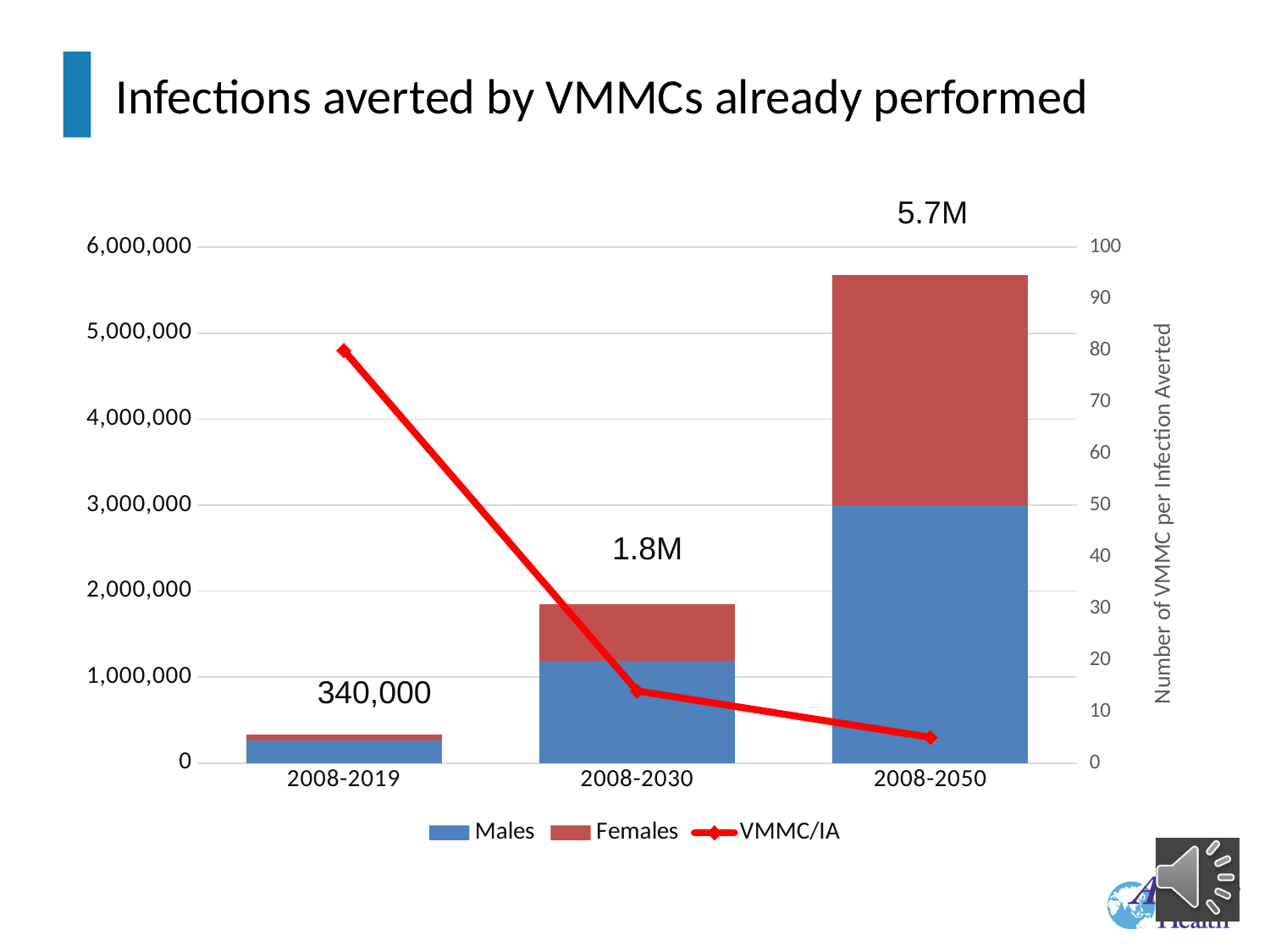
What is the total number of infections averted shown for 2008-2019? 340,000 What is the title of the secondary (right) vertical axis? Number of VMMC per Infection Averted How many series does the legend list? 3 How many periods are shown on the x axis? 3 Is the VMMC/IA value for 2008-2030 greater or less than 20? less Which period has the lowest total infections averted? 2008-2019 Does the VMMC/IA line rise or fall from 2008-2019 to 2008-2050? fall What is the total number of infections averted shown for 2008-2030? 1.8M What kind of chart is used for the Males and Females series? bar chart Which period has the highest total infections averted? 2008-2050 Is the VMMC/IA value for 2008-2019 greater or less than 70? greater What is the total number of infections averted shown for 2008-2050? 5.7M